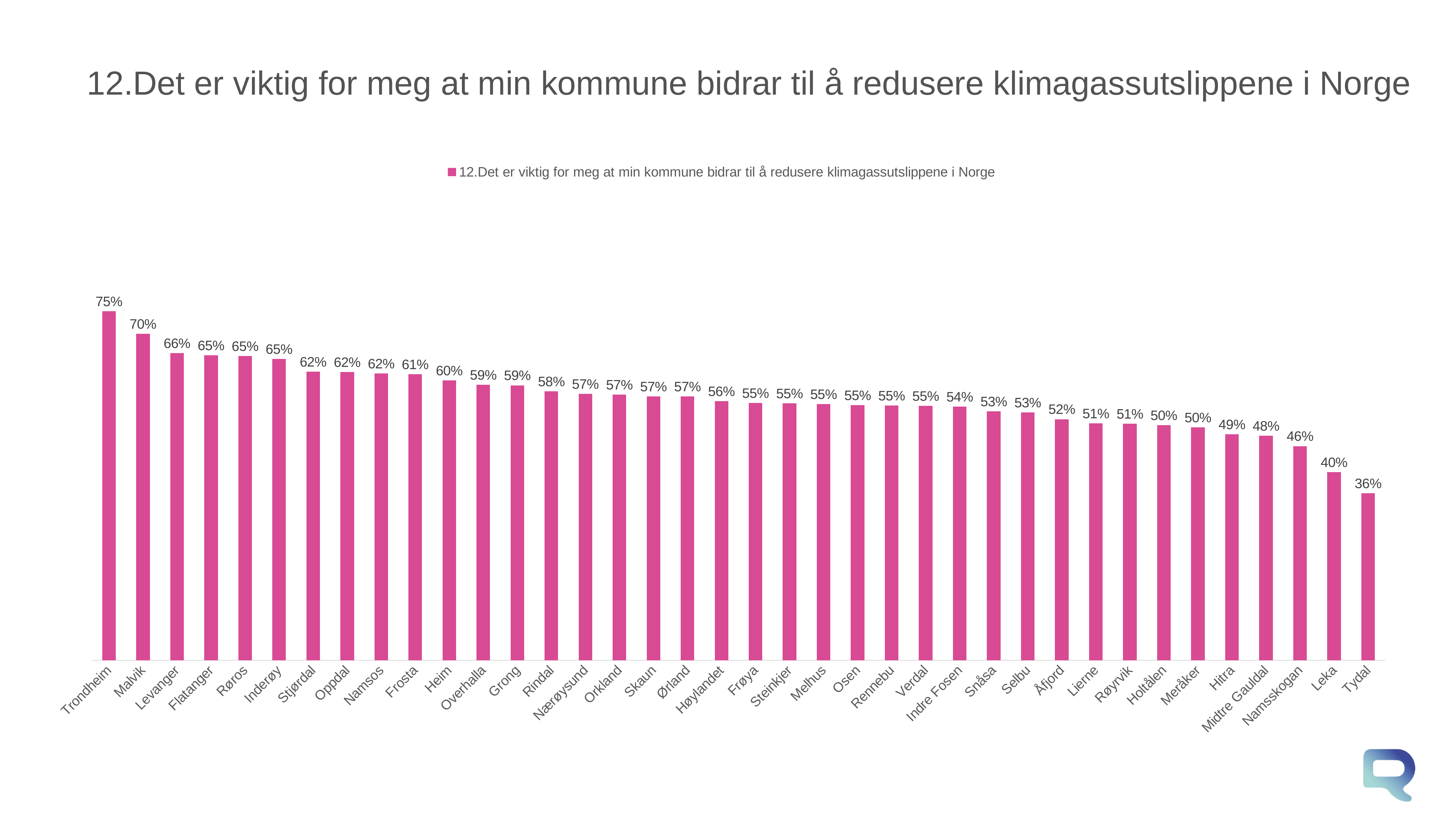
Which municipality has the highest value? Trondheim Do the values rise or fall from left to right along the x axis? Fall What is the difference between the values for Trondheim and Malvik? 5% What is the value for Trondheim? 75% Which municipality has the lowest value? Tydal How many municipalities are shown on the x axis? 38 What is the difference between the values for Levanger and Tydal? 30% What is the value for Steinkjer? 55% Which has a larger value, Hitra or Namsskogan? Hitra What kind of chart is shown on the slide? Bar chart What is the value for Leka? 40% What is the value for Tydal? 36%